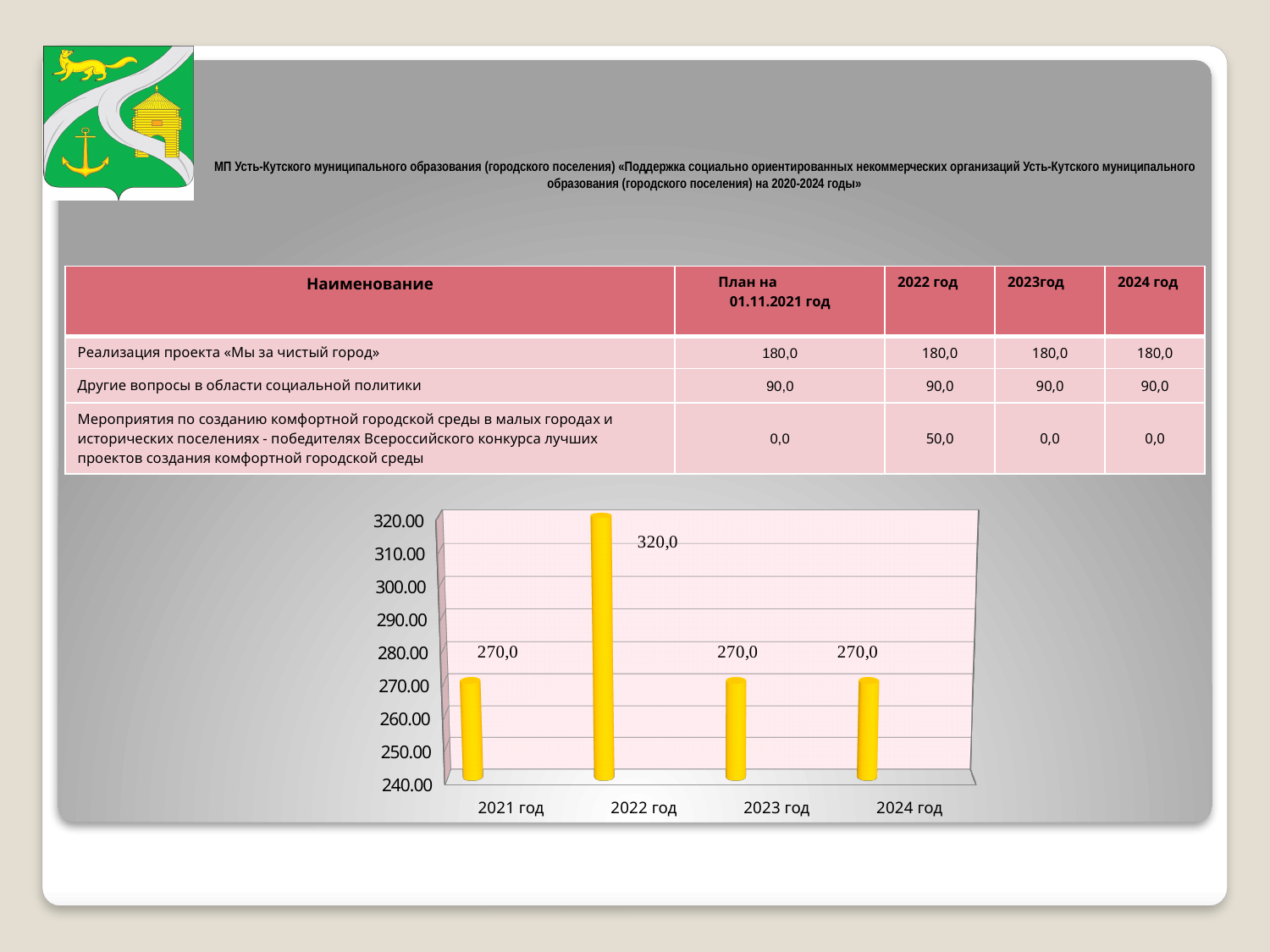
Does the value rise or fall from 2022 год to 2023 год? fall What kind of chart is shown on the slide? bar chart What is the value for 2024 год in the chart? 270,0 What is the value for 2021 год in the chart? 270,0 What colour are the bars in the chart? yellow What is the value for 2022 год in the chart? 320,0 Is the value for 2023 год greater or less than 300.00? less Which year has the highest value in the chart? 2022 год How many years are shown on the x axis of the chart? 4 Which is larger, the value for 2022 год or the value for 2021 год? 2022 год What is the difference between the values for 2022 год and 2023 год? 50,0 Is the value for 2022 год greater or less than 300.00? greater